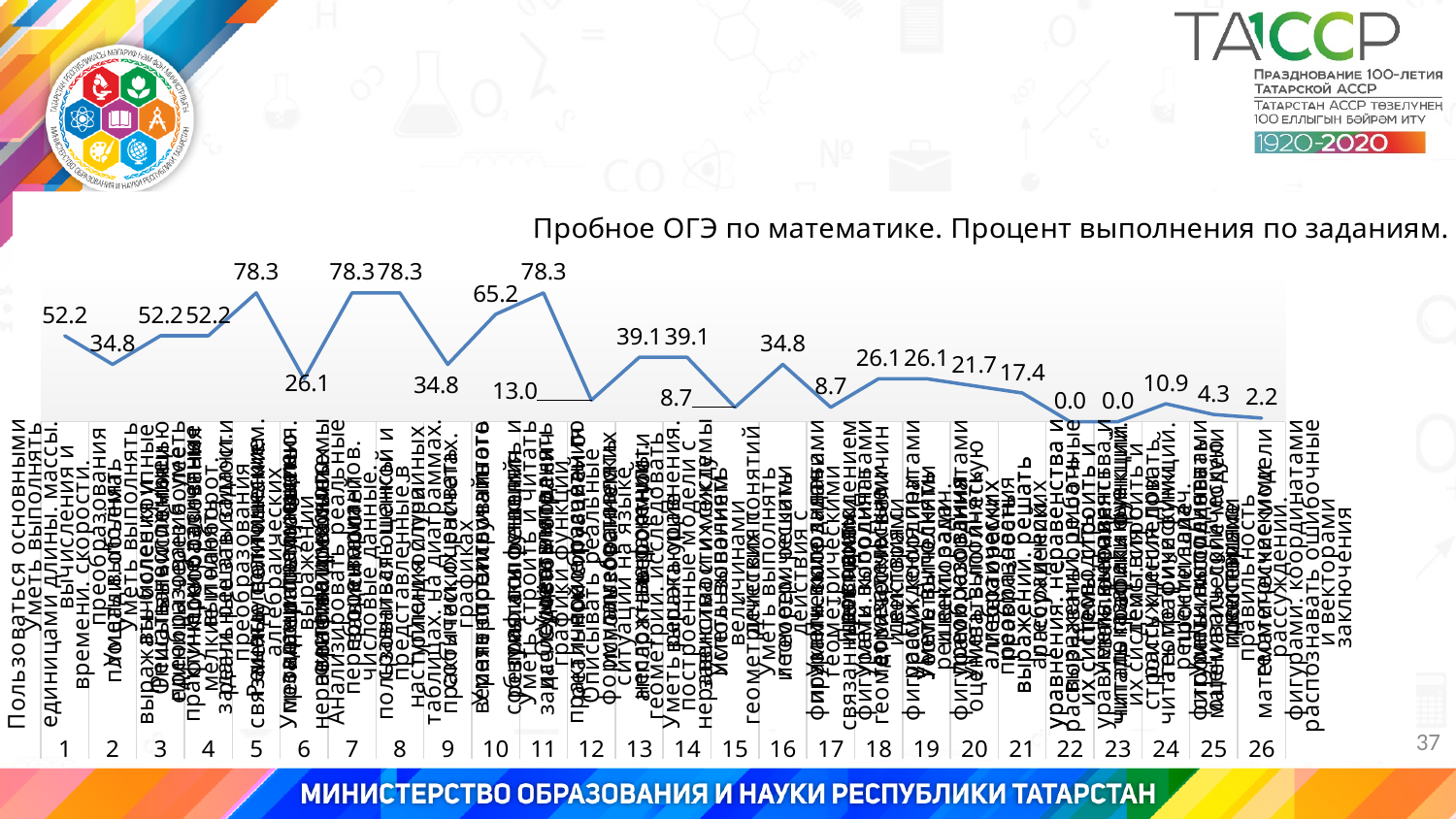
What is the completion percentage for task 1? 52.2 What kind of chart is shown on the slide? line chart What is the highest completion percentage shown on the chart? 78.3 Which has a higher completion percentage, task 13 or task 16? task 13 What is the title of the chart? Пробное ОГЭ по математике. Процент выполнения по заданиям. What is the completion percentage for task 10? 65.2 Do the values rise or fall from task 19 to task 23? fall What is the difference between the values for task 24 and task 26? 8.7 Which tasks have the lowest completion percentage of 0.0? 22 and 23 What is the difference between the values for task 5 and task 6? 52.2 How many tasks (points) are plotted on the chart? 26 What is the completion percentage for task 20? 21.7